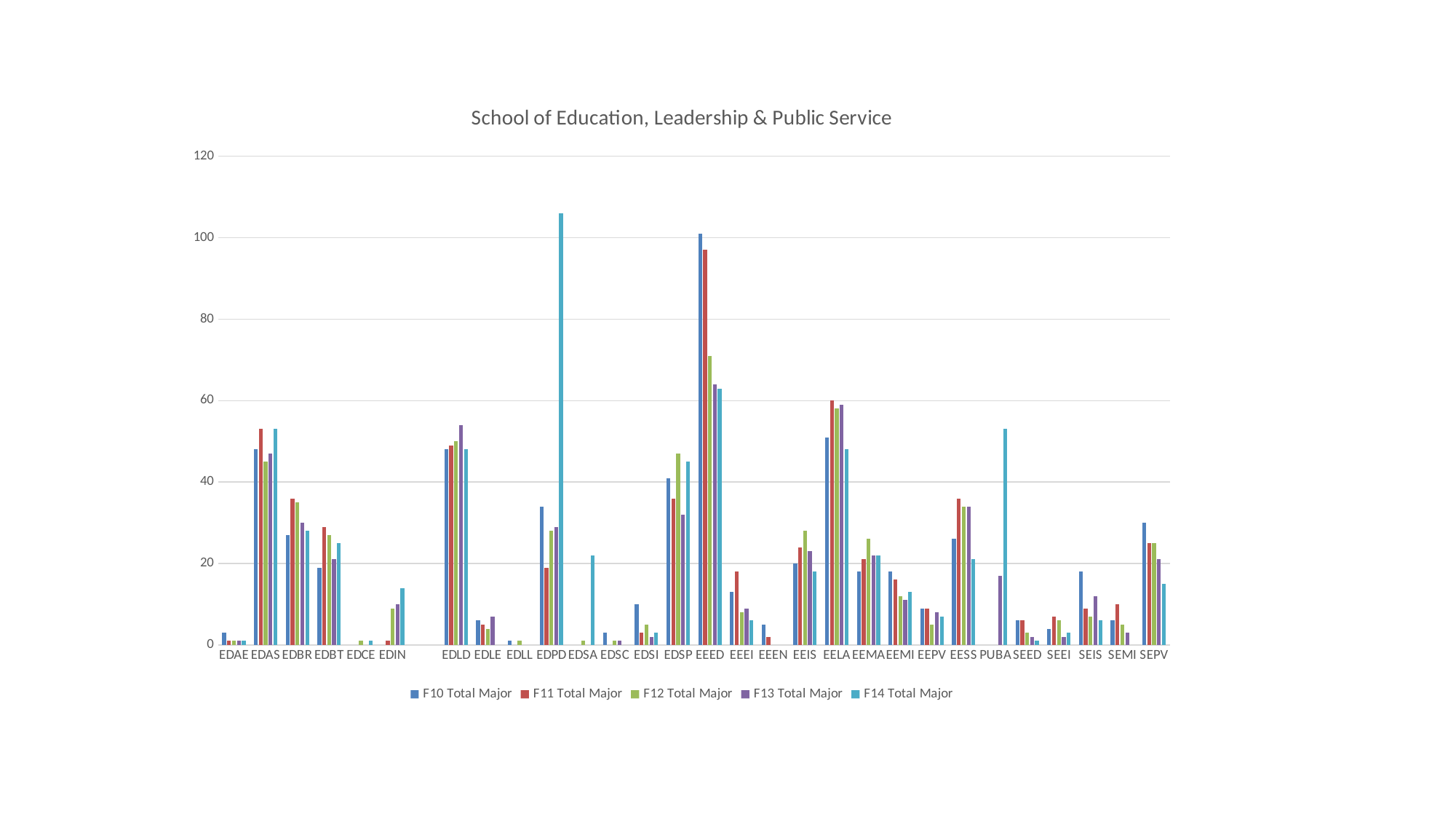
What type of chart is shown on the slide? bar chart What is the title of the chart? School of Education, Leadership & Public Service Which category has the tallest F10 Total Major bar? EEED Which is larger: the F14 Total Major value for EDPD or the F14 Total Major value for PUBA? EDPD Is the F14 Total Major value for EDIN greater or less than 20? less Which category has the tallest F14 Total Major bar? EDPD Is the F10 Total Major value for SEPV greater or less than 20? greater Is the F12 Total Major value for EEED greater or less than 60? greater How many series does the legend list? 5 Which is larger: the F10 Total Major value for EEED or the F10 Total Major value for EELA? EEED